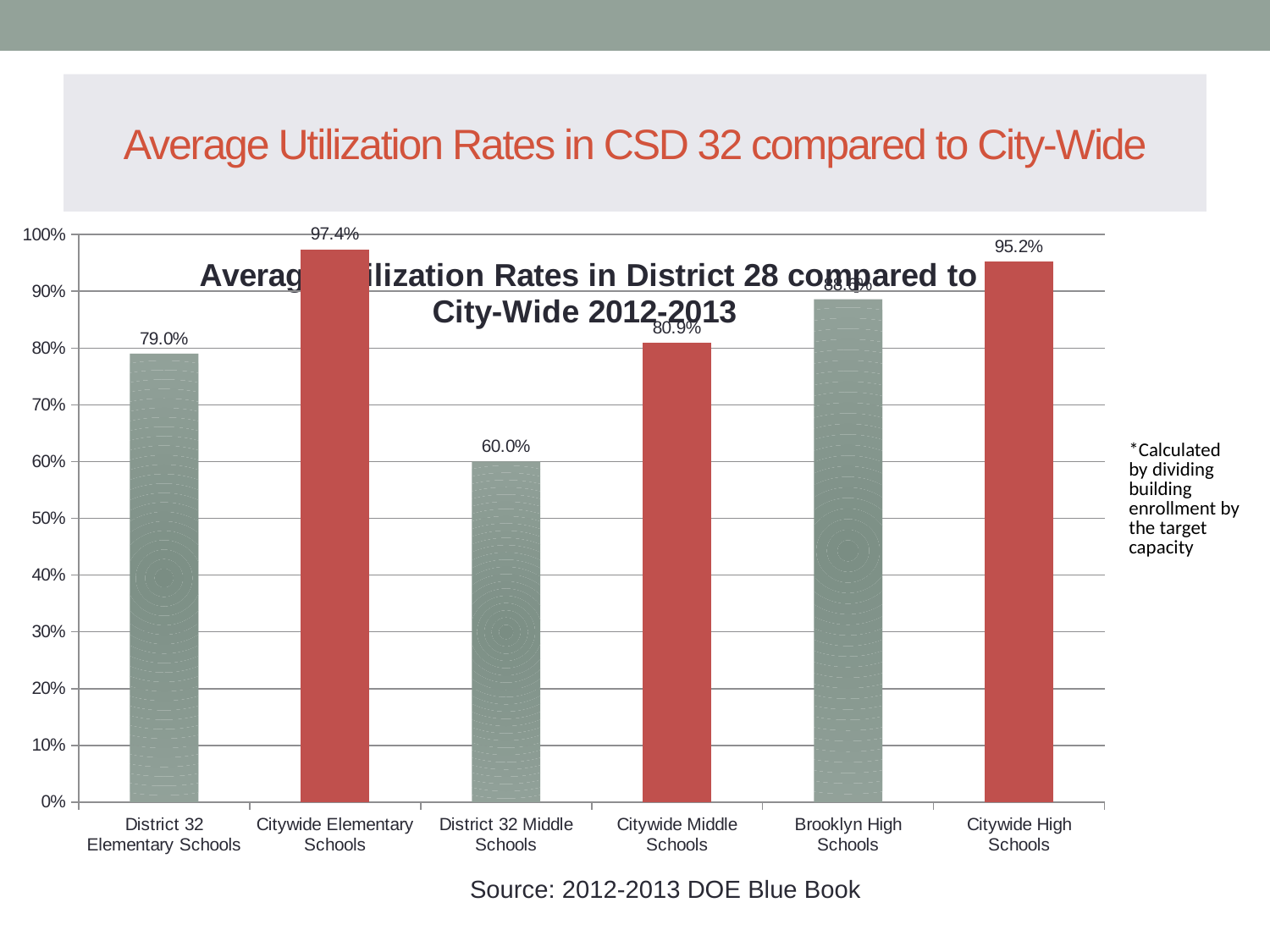
Is the utilization rate for Brooklyn High Schools greater or less than 80%? greater How much higher is the utilization rate for Citywide Elementary Schools than for District 32 Elementary Schools? 18.4% What is the average utilization rate for Citywide High Schools? 95.2% Which category has the highest average utilization rate? Citywide Elementary Schools What kind of chart is shown on the slide? bar chart What is the average utilization rate for District 32 Middle Schools? 60.0% What is the average utilization rate for Citywide Middle Schools? 80.9% Which has a higher utilization rate: District 32 Middle Schools or Citywide Middle Schools? Citywide Middle Schools What is the average utilization rate for District 32 Elementary Schools? 79.0% How many categories are shown on the x axis of the chart? 6 Which category has the lowest average utilization rate? District 32 Middle Schools What is the average utilization rate for Citywide Elementary Schools? 97.4%